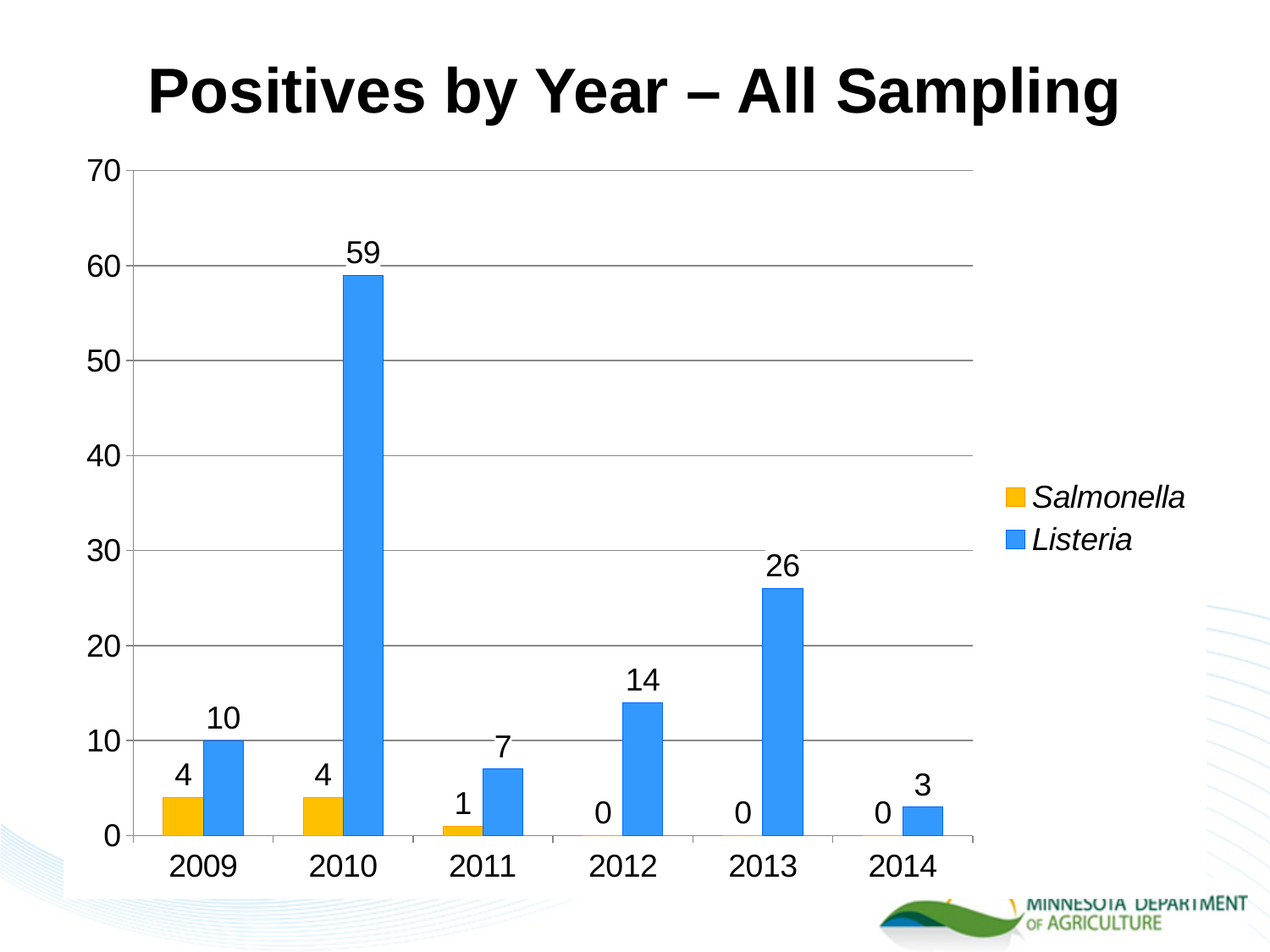
Which year has the highest Listeria value? 2010 How many series does the legend list? 2 What is the Salmonella value for 2011? 1 What is the title of the chart? Positives by Year – All Sampling What is the difference between the Listeria values for 2013 and 2012? 12 Which is larger, the Listeria value for 2009 or the Listeria value for 2011? 2009 What is the Listeria value for 2010? 59 What is the Listeria value for 2014? 3 Which year has the lowest Listeria value? 2014 How many years are shown on the x axis? 6 What kind of chart is shown on the slide? bar chart Is the Listeria value for 2013 greater or less than 20? greater